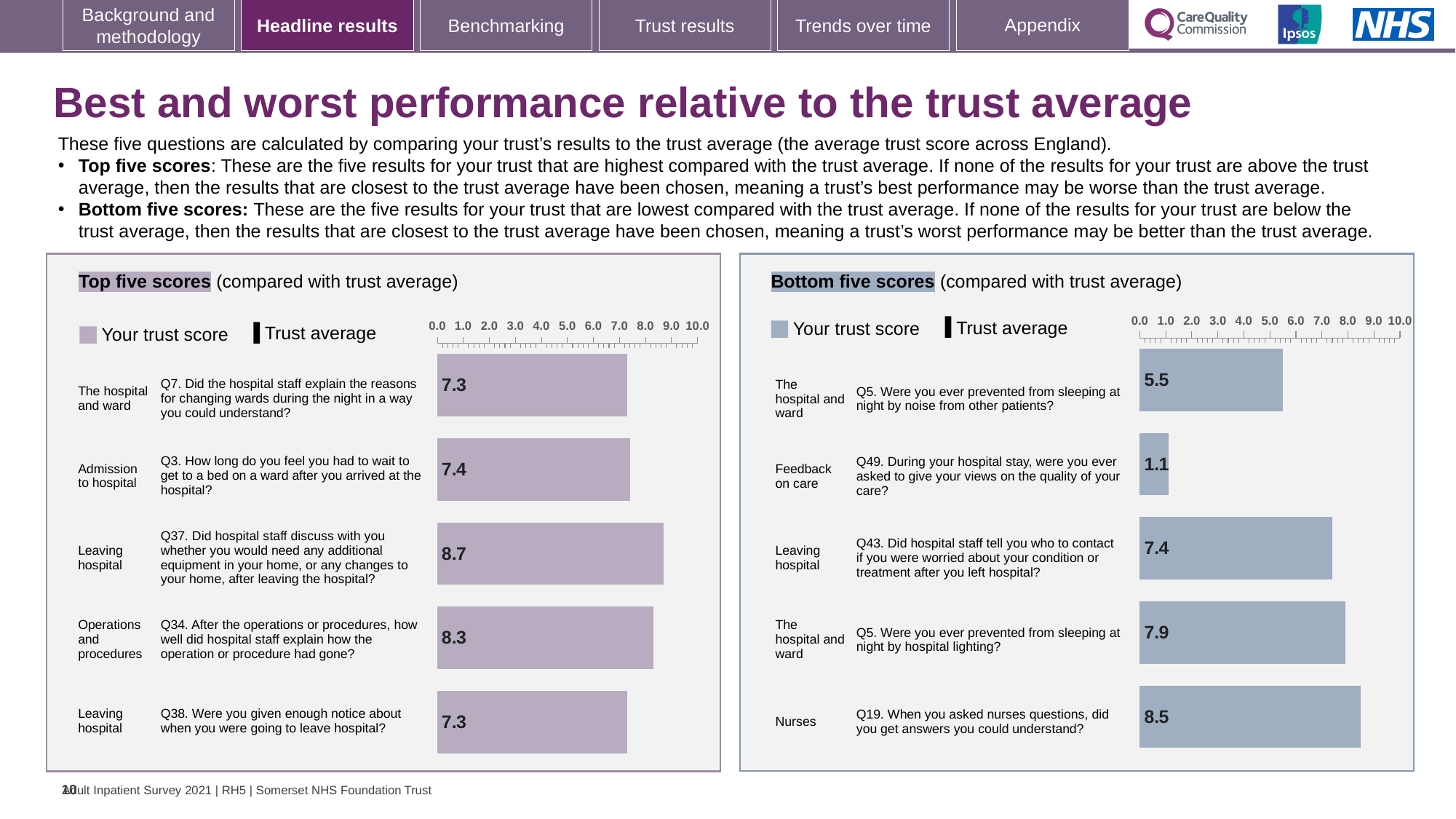
In the Bottom five scores chart, what is the trust score for Q5 about being prevented from sleeping at night by hospital lighting? 7.9 In the Bottom five scores chart, which question has the highest trust score? Q19 In the Top five scores chart, what is the trust score for Q37 about discussing additional equipment or changes to your home after leaving hospital? 8.7 In the Bottom five scores chart, which question has the lowest trust score? Q49 What type of chart is used in the Bottom five scores panel? Bar chart In the Bottom five scores chart, what is the trust score for Q49 about being asked to give your views on the quality of your care? 1.1 In the Top five scores chart, what is the trust score for Q3 about how long you had to wait to get to a bed on a ward? 7.4 In the Top five scores chart, which question has the highest trust score? Q37 In the Bottom five scores chart, is the trust score for Q5 about noise from other patients greater or less than the score for Q43 about who to contact if worried after leaving hospital? less In the Bottom five scores chart, what is the difference between the trust scores for Q19 and Q49? 7.4 In the Top five scores chart, what is the difference between the trust scores for Q37 and Q34? 0.4 How many questions are plotted in the Top five scores chart? 5